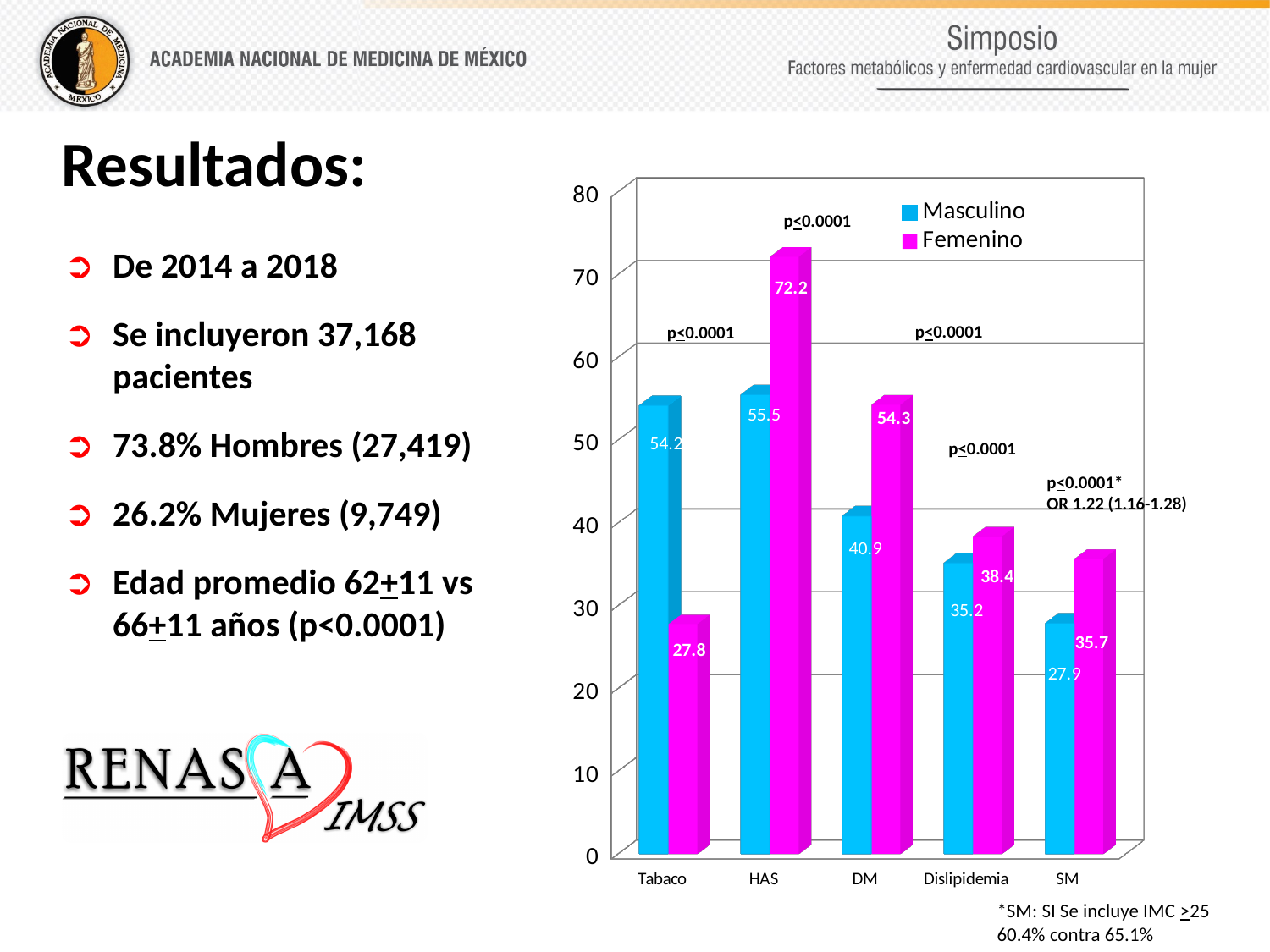
What is the Femenino value for SM? 35.7 What is the Masculino value for DM? 40.9 For Tabaco, which is larger: the Masculino value or the Femenino value? Masculino What kind of chart is shown on the slide? Bar chart What is the Femenino value for HAS? 72.2 Which category has the lowest Masculino value? SM Which colour represents the Femenino series? Magenta Which category has the highest Femenino value? HAS What is the Masculino value for Tabaco? 54.2 How many series does the legend list? 2 What is the difference between the Femenino and Masculino values for HAS? 16.7 How many categories are shown on the x axis? 5